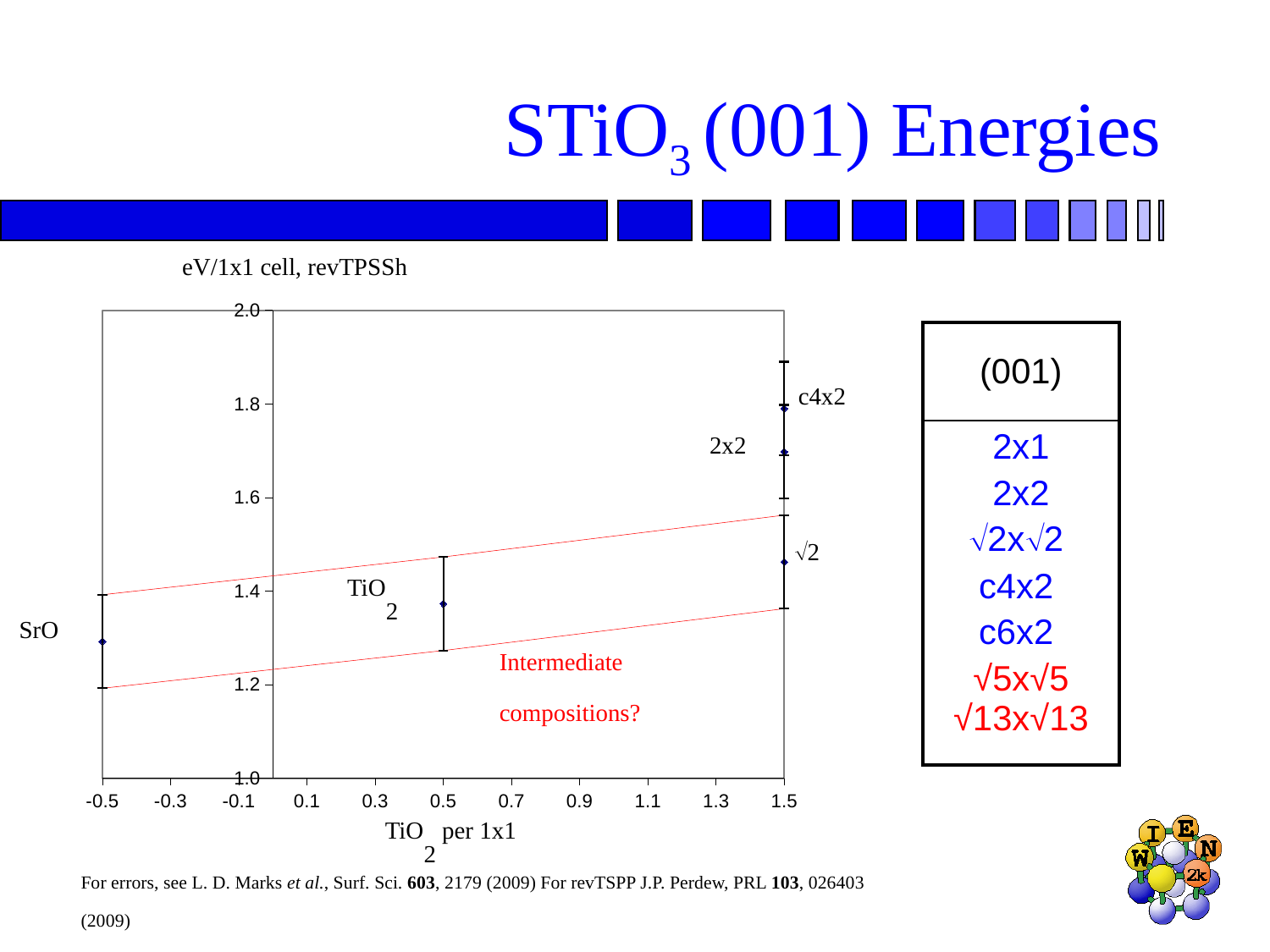
Which has the higher energy value, c4x2 or 2x2? c4x2 Is the energy value for √2 greater or less than 1.6? less At what value of TiO2 per 1x1 is the SrO point plotted? -0.5 Is the energy value for TiO2 greater or less than 1.6? less What unit label is shown above the y axis of the chart? eV/1x1 cell, revTPSSh What kind of chart is shown on the slide? scatter chart Which has the higher energy value, √2 or 2x2? 2x2 Which labelled point has the highest energy value? c4x2 Is the energy value for c4x2 greater or less than 1.6? greater At what value of TiO2 per 1x1 are the c4x2, 2x2 and √2 points plotted? 1.5